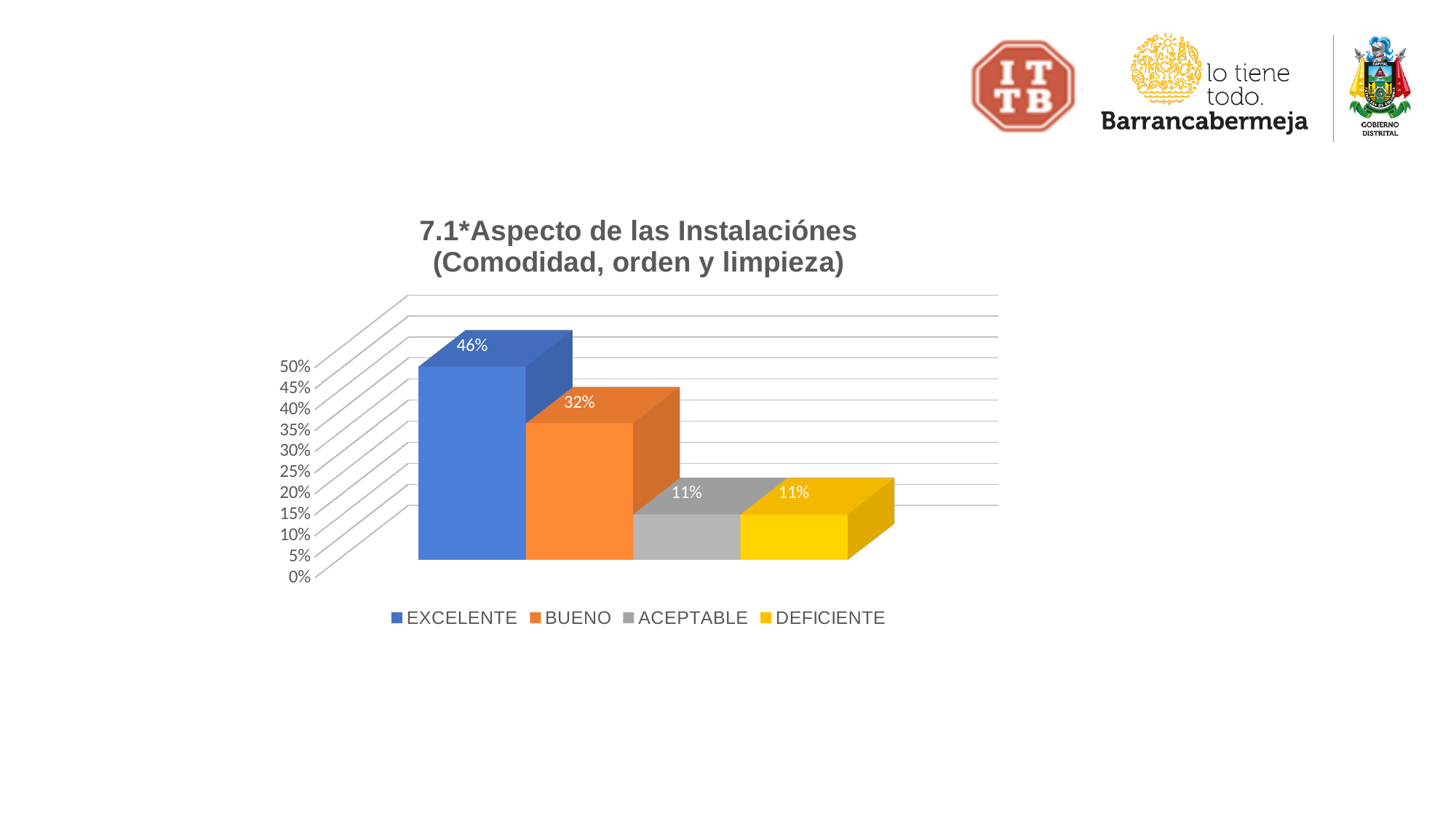
What is the difference between the values for EXCELENTE and BUENO? 14% How many series does the legend list? 4 What is the title of the chart? 7.1*Aspecto de las Instalaciónes (Comodidad, orden y limpieza) What is the value for ACEPTABLE? 11% Which is larger, the value for BUENO or the value for DEFICIENTE? BUENO What colour is the bar for ACEPTABLE? grey What is the value for EXCELENTE? 46% What is the value for DEFICIENTE? 11% What kind of chart is shown on the slide? bar chart Which category has the highest value? EXCELENTE What is the value for BUENO? 32% What is the difference between the values for BUENO and ACEPTABLE? 21%